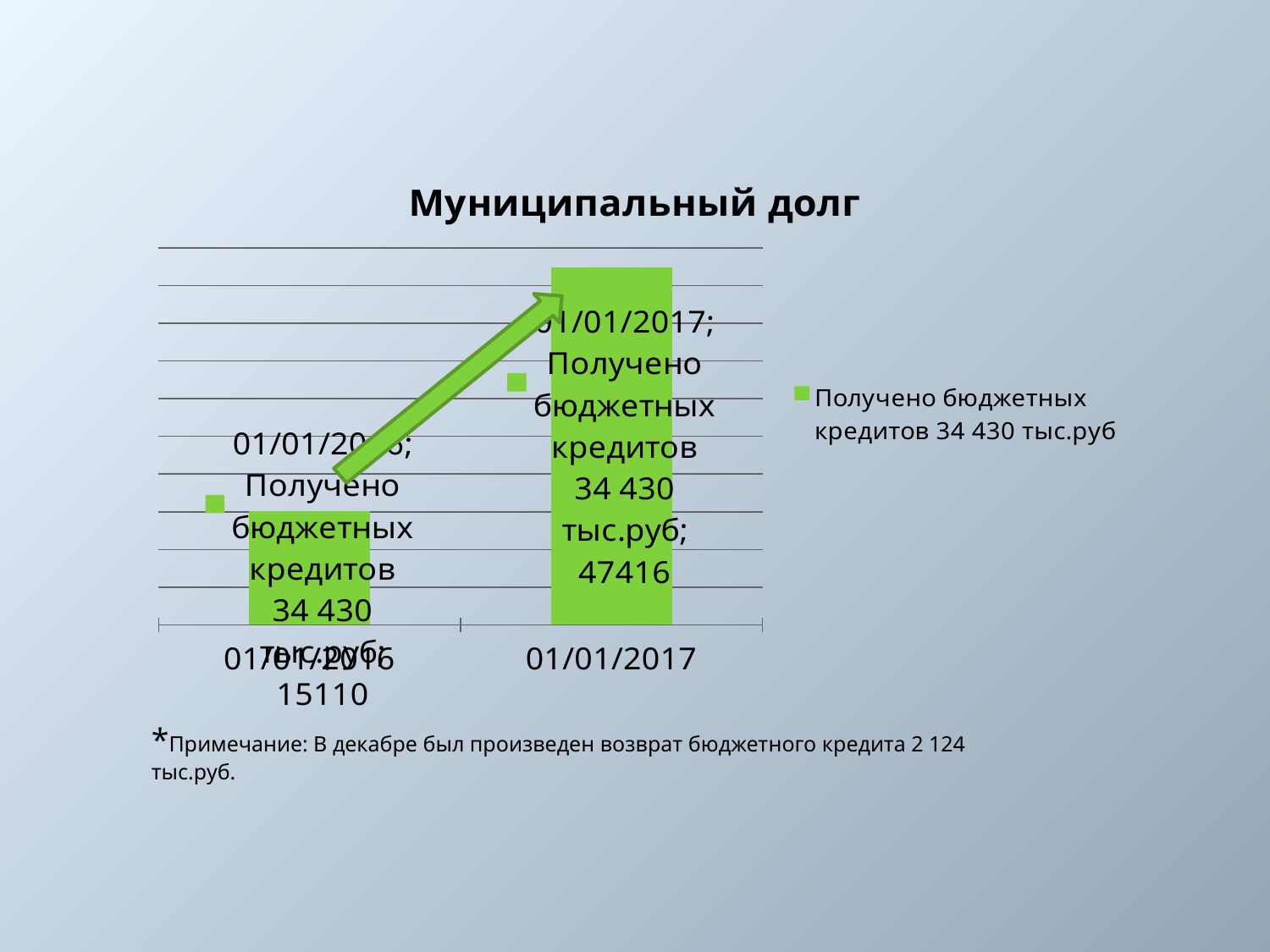
What is the difference between the values for 01/01/2017 and 01/01/2016? 32306 What is the value for 01/01/2017? 47416 Which is larger, the value for 01/01/2016 or the value for 01/01/2017? 01/01/2017 Which category has the highest value? 01/01/2017 What is the value for 01/01/2016? 15110 How many series does the legend list? 1 What type of chart is shown on the slide? bar chart Do the values rise or fall from 01/01/2016 to 01/01/2017? rise What is the legend entry for the series? Получено бюджетных кредитов 34 430 тыс.руб Which category has the lowest value? 01/01/2016 What is the title of the chart? Муниципальный долг How many categories are shown on the x axis? 2